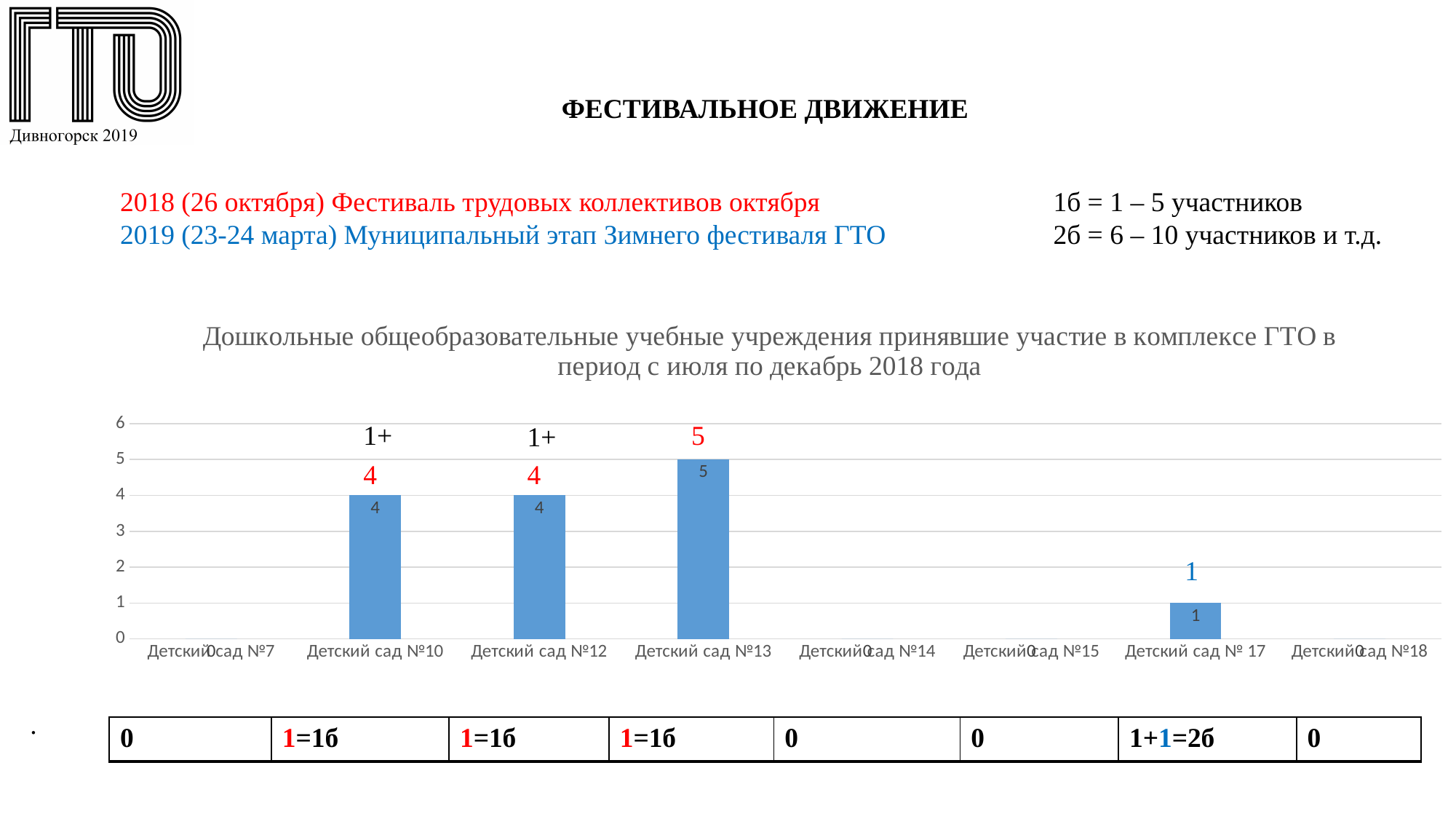
Which category has the highest value? Детский сад №13 What type of chart is shown on the slide? bar chart What is the value for Детский сад №10? 4 What is the value for Детский сад №13? 5 What is the value for Детский сад № 17? 1 Which is larger, the value for Детский сад №12 or the value for Детский сад № 17? Детский сад №12 How many categories are shown on the x axis? 8 What is the difference between the values for Детский сад №10 and Детский сад № 17? 3 What is the title of the chart? Дошкольные общеобразовательные учебные учреждения принявшие участие в комплексе ГТО в период с июля по декабрь 2018 года What is the value for Детский сад №14? 0 What is the difference between the values for Детский сад №13 and Детский сад №12? 1 How many categories have a value of 0? 4